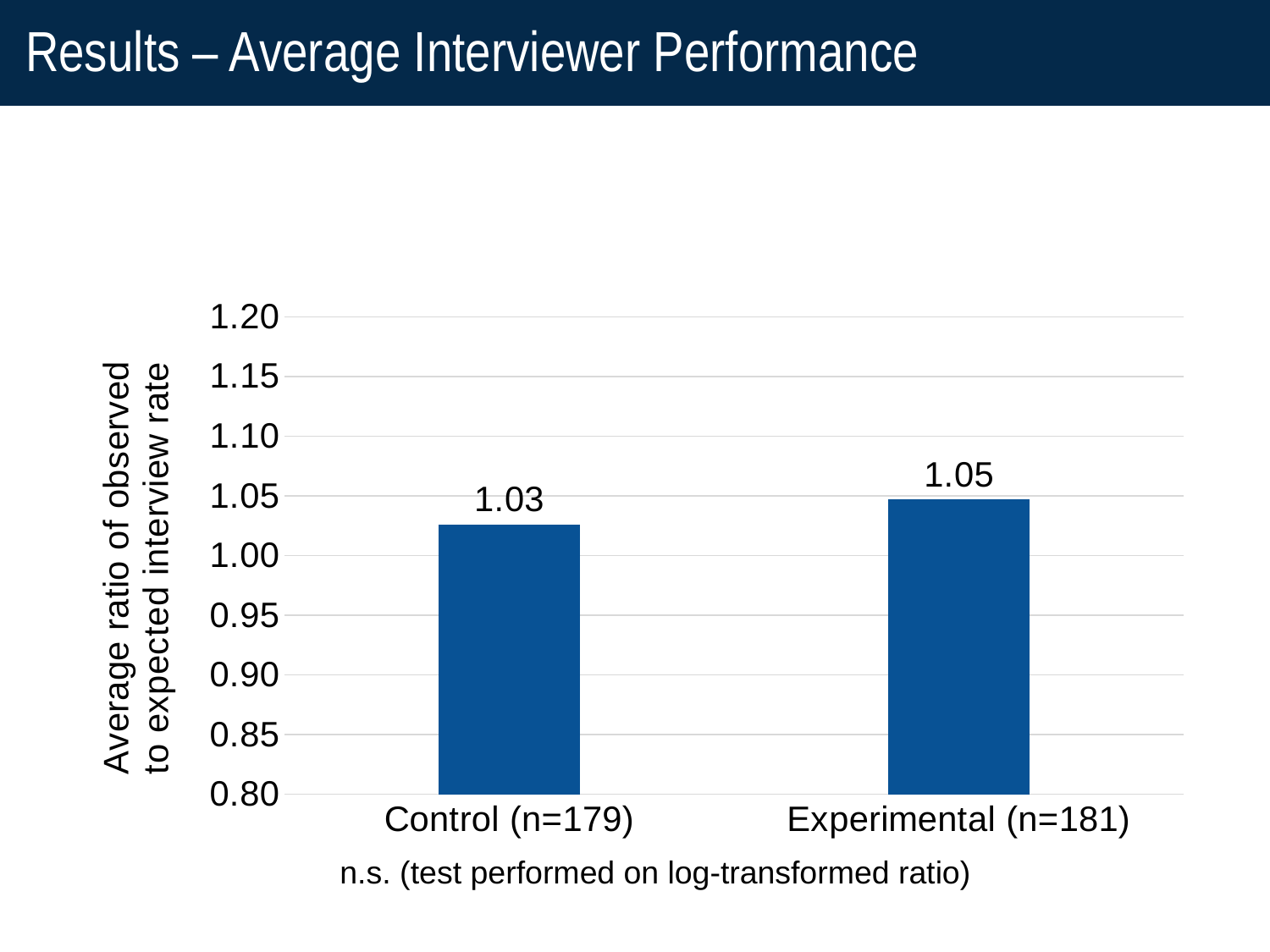
Is the value for Experimental (n=181) greater or less than 1.10? less What is the lowest value shown on the y axis? 0.80 What is the title of the slide? Results – Average Interviewer Performance Which category has the lower average ratio? Control (n=179) Is the value for Control (n=179) greater or less than 1.00? greater What is the value for Experimental (n=181)? 1.05 How many categories are shown on the x axis? 2 Which category has the higher average ratio? Experimental (n=181) What kind of chart is shown on the slide? Bar chart What is the difference between the Experimental (n=181) and Control (n=179) values? 0.02 What is the label of the y axis? Average ratio of observed to expected interview rate What is the value for Control (n=179)? 1.03